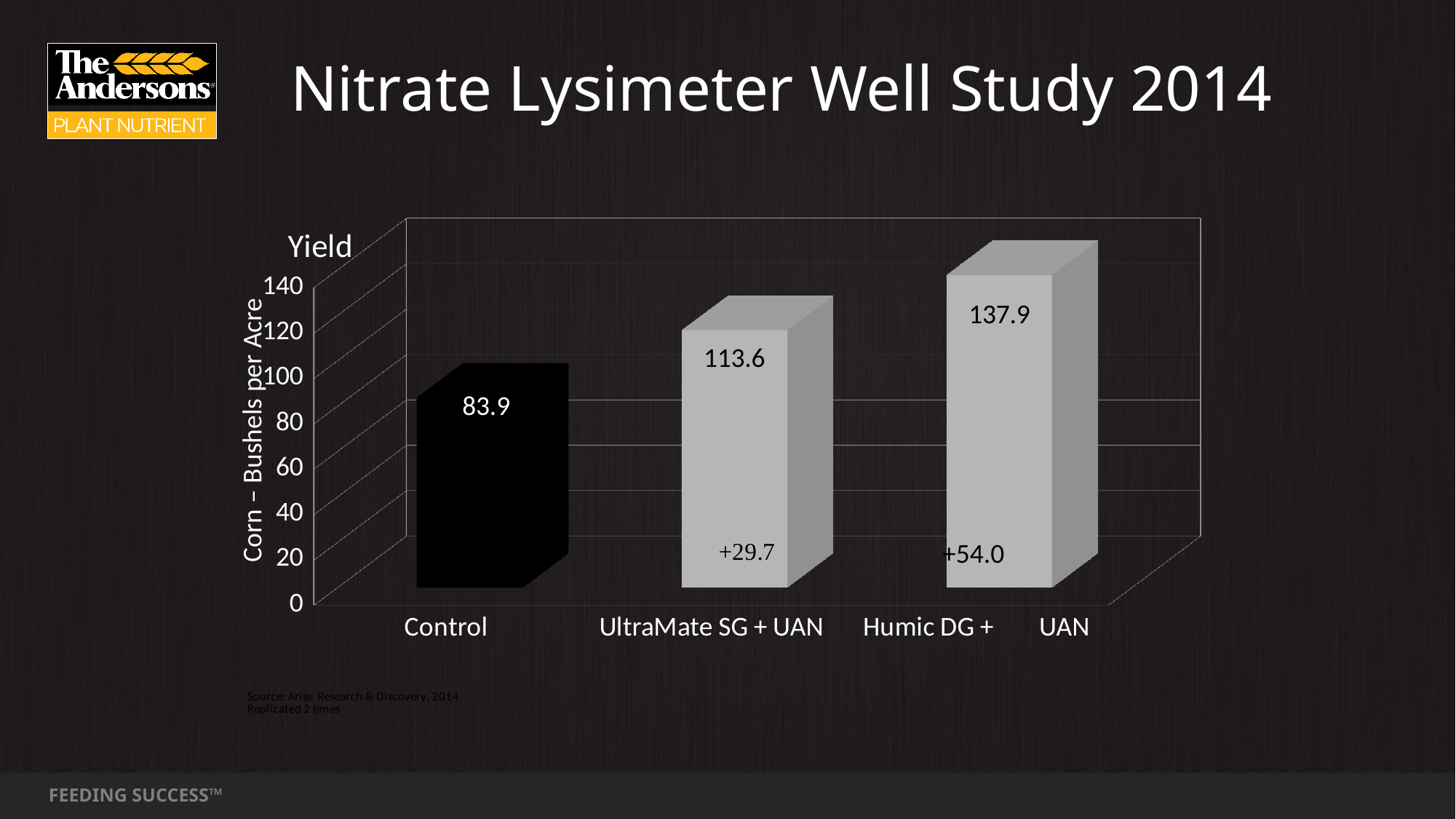
What is the title of the chart? Yield What is the yield for Humic DG + UAN? 137.9 What is the difference in yield between Humic DG + UAN and the Control? 54.0 How many treatments are shown in the chart? 3 Which has a higher yield, UltraMate SG + UAN or Humic DG + UAN? Humic DG + UAN Which treatment has the highest yield? Humic DG + UAN What is the yield for UltraMate SG + UAN? 113.6 What is the y-axis label of the chart? Corn – Bushels per Acre What is the yield for the Control treatment? 83.9 What is the difference in yield between UltraMate SG + UAN and the Control? 29.7 What kind of chart is shown on the slide? Bar chart Which treatment has the lowest yield? Control